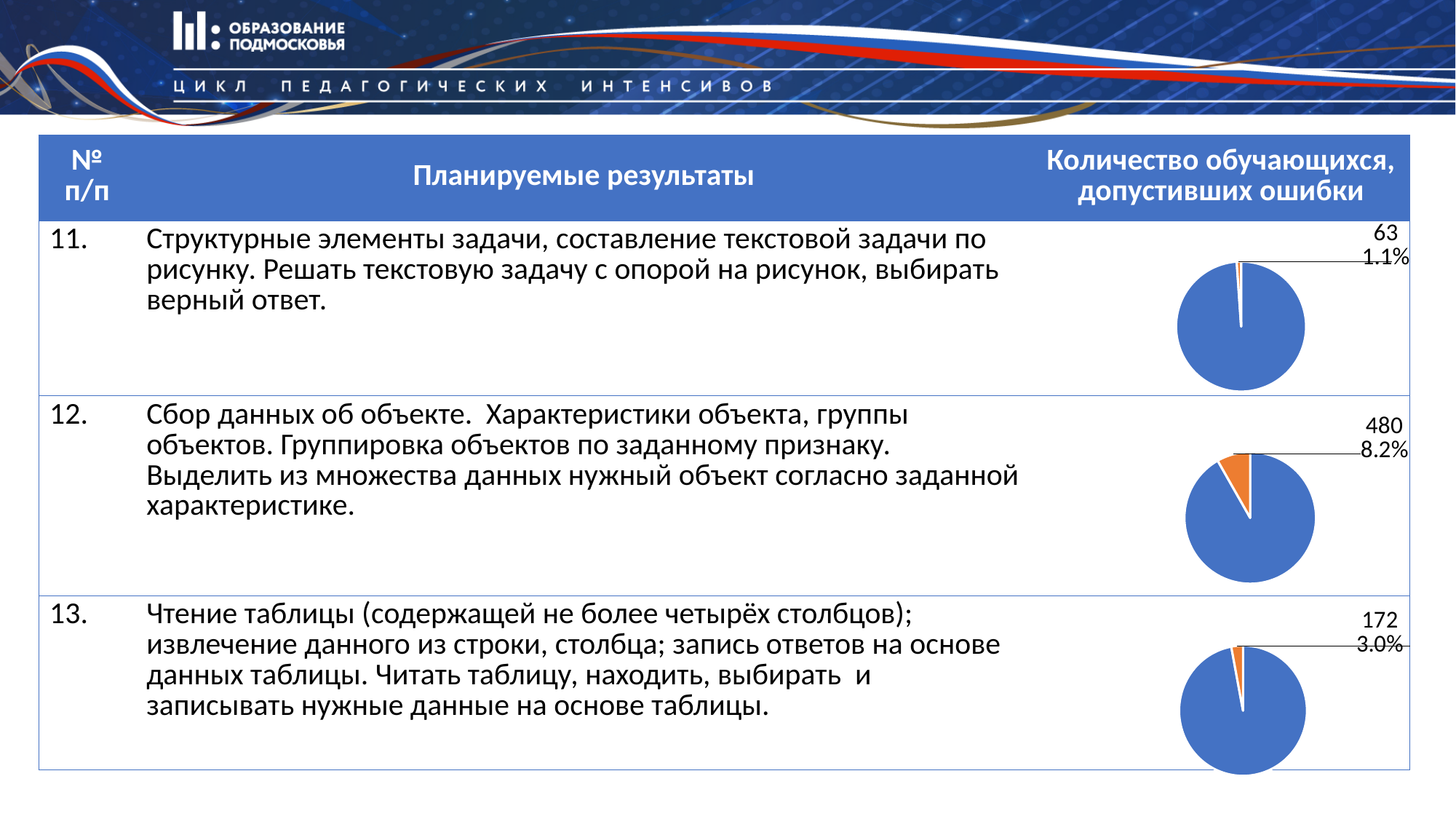
Which is larger: the number of students who made errors in row 13 or in row 11? row 13 What is the difference between the number of students who made errors in row 12 and in row 11? 417 What type of chart is used in the right-hand column of the table? pie chart Which row's pie chart shows the largest number of students who made errors? 12 How many pie charts are shown on the slide? 3 In the pie chart for row 12, how many students made errors according to the data label? 480 In the pie chart for row 11, how many students made errors according to the data label? 63 In the pie chart for row 12, what percentage share does the orange slice represent? 8.2% In the pie chart for row 11, what percentage share does the orange slice represent? 1.1% In the pie chart for row 13, how many students made errors according to the data label? 172 In the pie chart for row 13, what percentage share does the orange slice represent? 3.0% Which row's pie chart shows the smallest number of students who made errors? 11